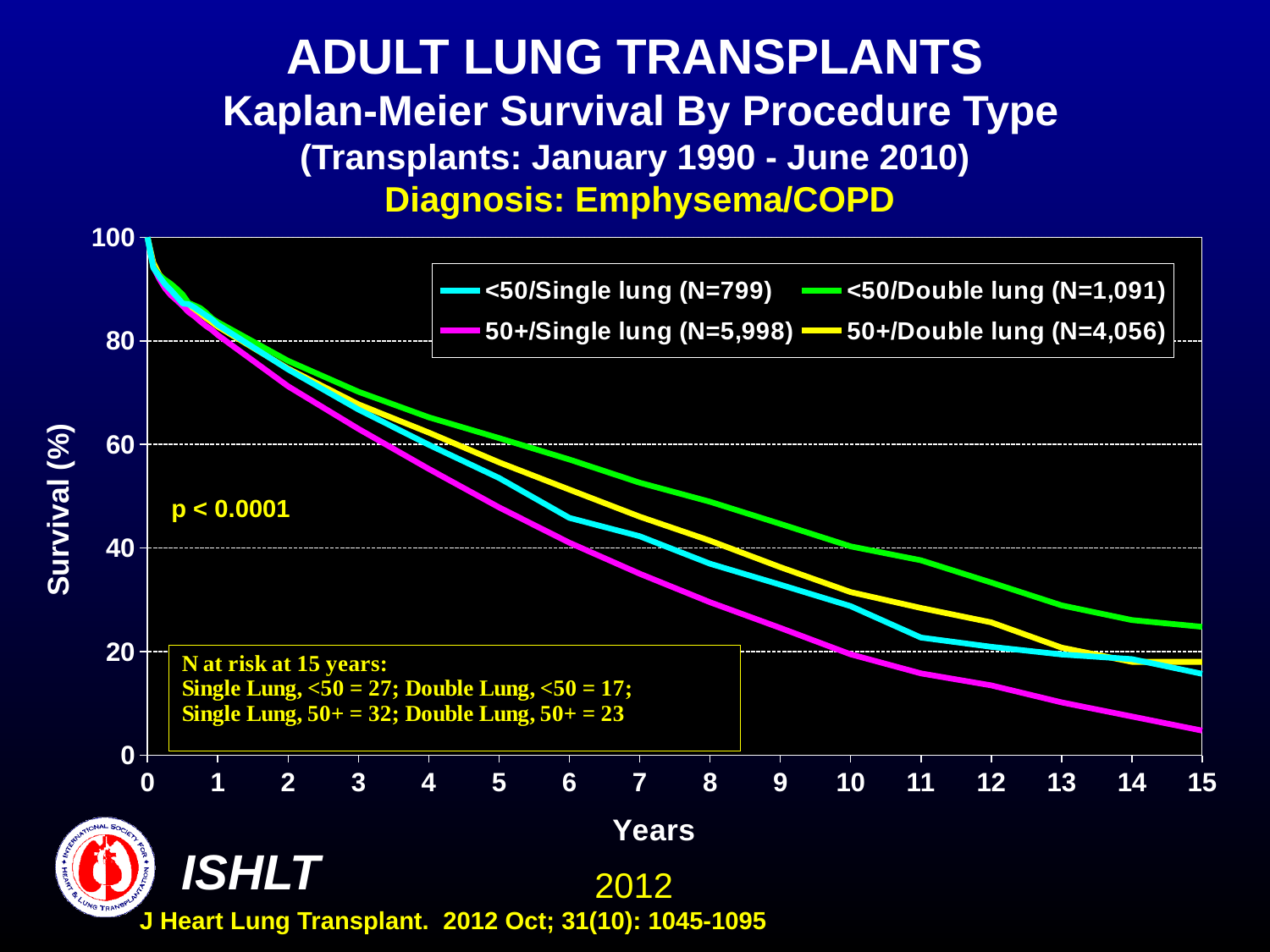
What is the difference between the N for 50+/Single lung and the N for 50+/Double lung? 1,942 Is the survival for 50+/Single lung at 15 years greater or less than 20? less Do the survival curves rise or fall as years increase? fall What is the N for the 50+/Single lung group shown in the legend? 5,998 Which group has the highest survival at 10 years? <50/Double lung What kind of chart is shown on the slide? line chart What is the N for the <50/Double lung group shown in the legend? 1,091 How many series does the legend list? 4 Which group has the lowest survival at 10 years? 50+/Single lung Which group has the larger N, <50/Single lung or <50/Double lung? <50/Double lung What p-value is printed on the chart? p < 0.0001 How many Double Lung, <50 patients are at risk at 15 years? 17